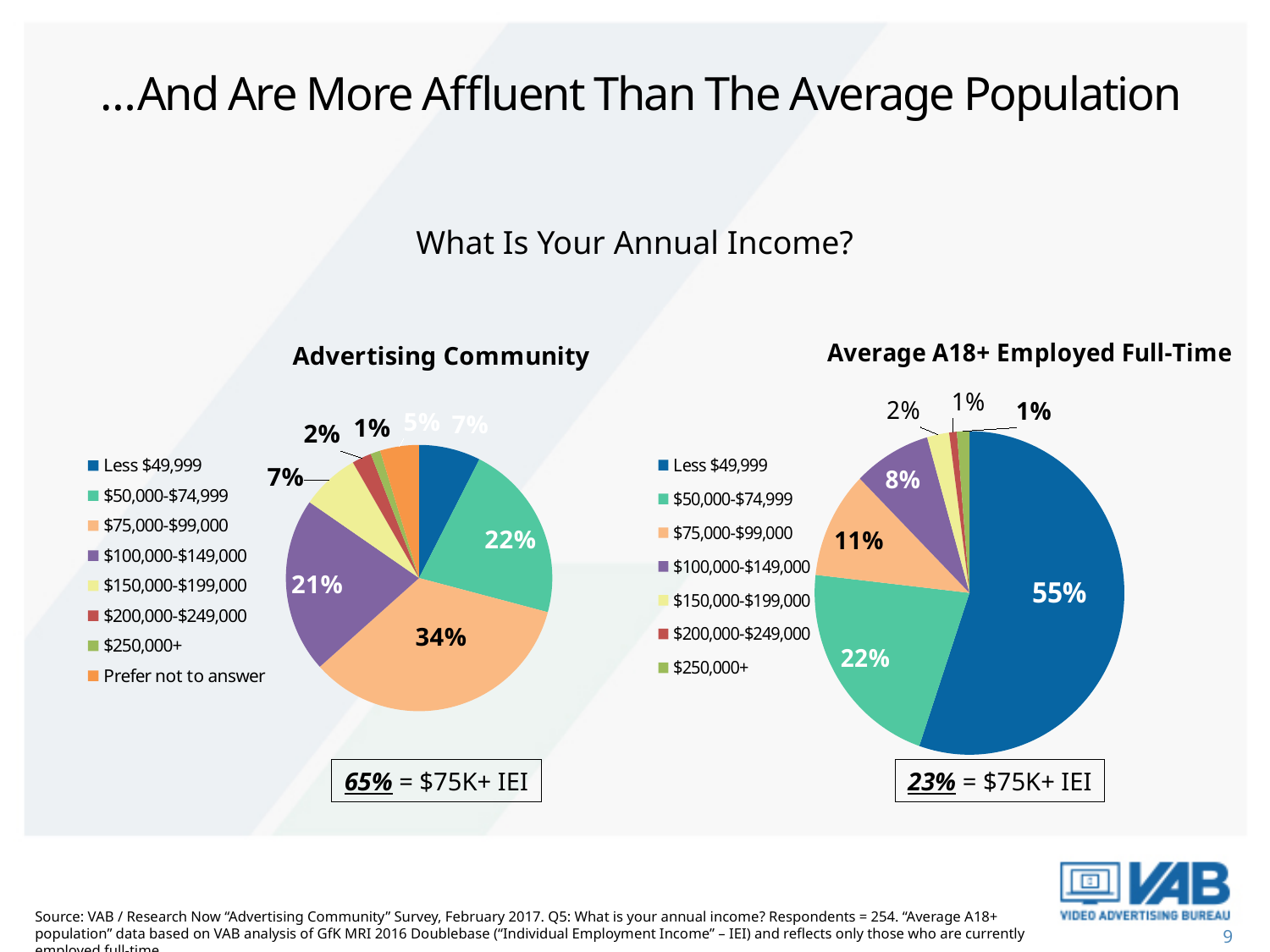
How many categories does the legend of the Average A18+ Employed Full-Time chart list? 7 What kind of charts are shown on the slide? Pie charts Which chart shows a larger share for $100,000-$149,000, Advertising Community or Average A18+ Employed Full-Time? Advertising Community In the Advertising Community chart, what share of respondents earn $75,000-$99,000? 34% In the Average A18+ Employed Full-Time chart, which income category has the largest slice? Less $49,999 In the Advertising Community chart, which income category has the largest slice? $75,000-$99,000 In the Average A18+ Employed Full-Time chart, what is the difference between the Less $49,999 slice and the $50,000-$74,999 slice? 33 percentage points How many categories does the legend of the Advertising Community chart list? 8 In the Average A18+ Employed Full-Time chart, what share earn $75,000-$99,000? 11% In the Advertising Community chart, which income category has the smallest slice? $250,000+ In the Average A18+ Employed Full-Time chart, what share earn less than $49,999? 55% What survey question is shown above the two pie charts? What Is Your Annual Income?